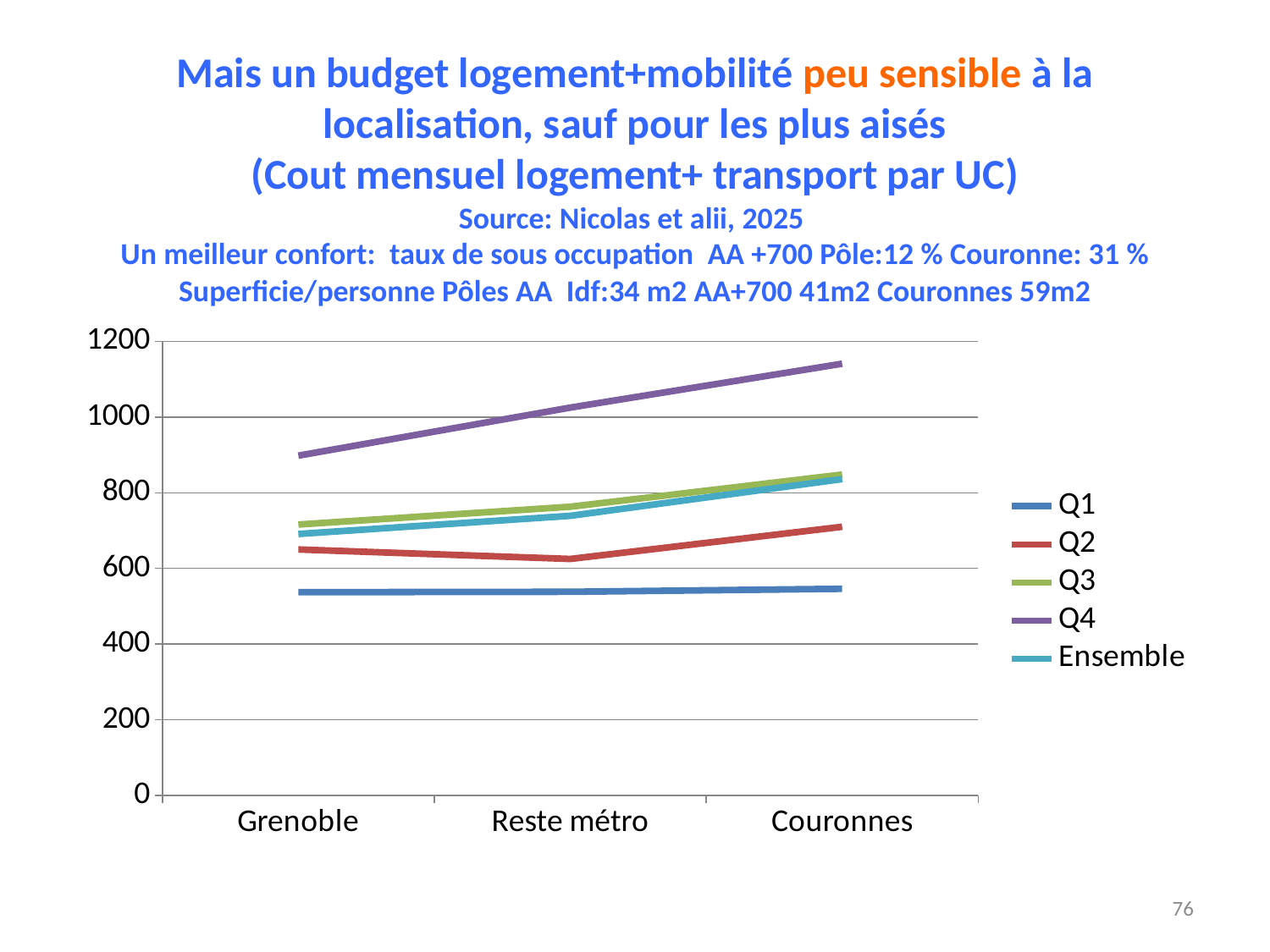
Is the value for Q3 at Couronnes greater or less than 800? greater How many series does the legend list? 5 Which is larger at Reste métro, the value for Q2 or the value for Q4? Q4 How many categories are shown on the x axis? 3 Is the value for Ensemble at Grenoble greater or less than 600? greater Is the value for Q4 at Couronnes greater or less than 1000? greater Which series has the lowest value at Grenoble? Q1 What kind of chart is shown on the slide? line chart Does the Q4 series rise or fall from Grenoble to Couronnes? rise Which series has the highest value at Couronnes? Q4